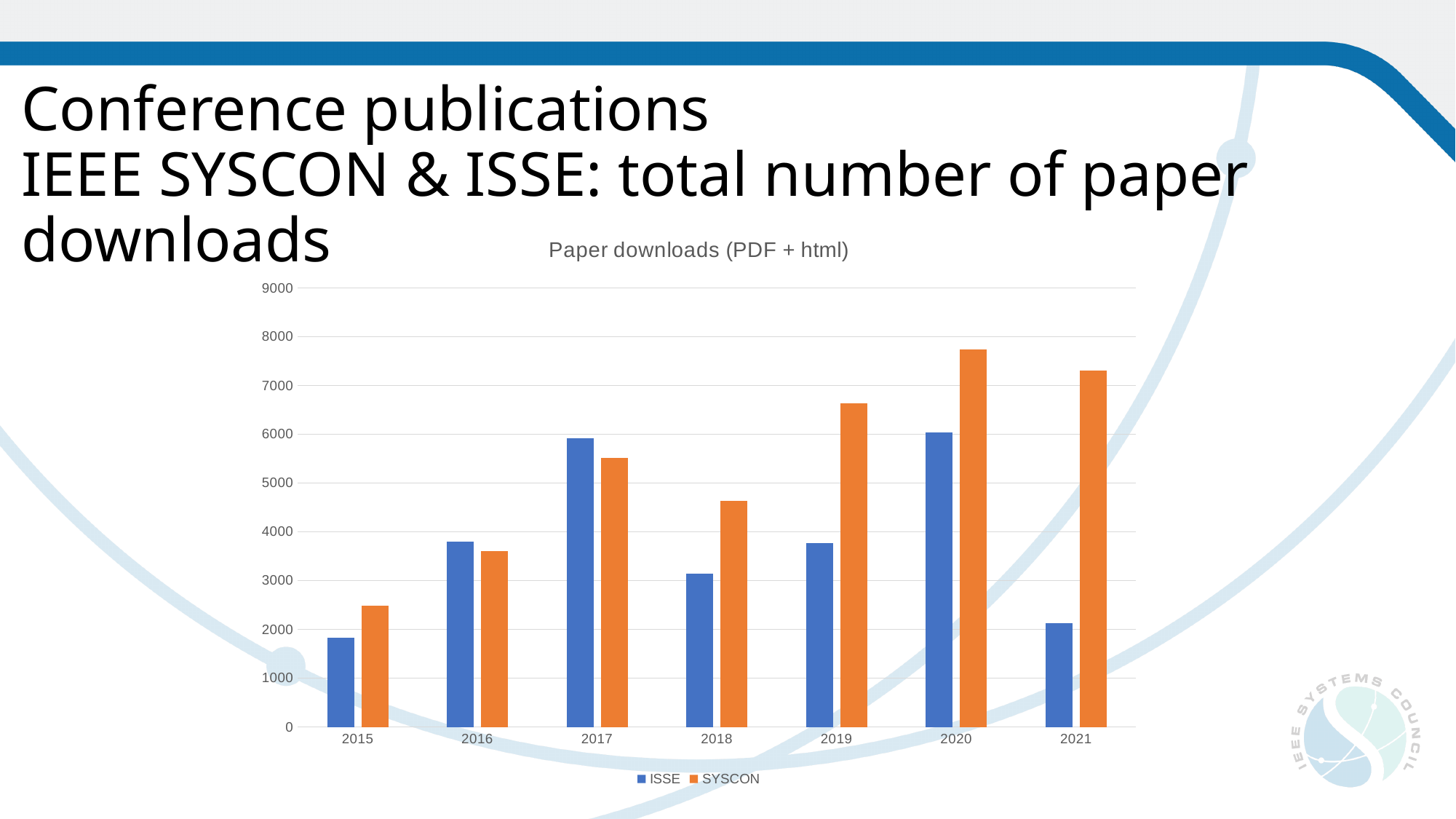
In 2017, which series has the larger value, ISSE or SYSCON? ISSE In 2019, which series has the larger value, ISSE or SYSCON? SYSCON Is the SYSCON value for 2018 greater or less than 4000? greater In which year is the SYSCON value highest? 2020 Is the ISSE value for 2015 greater or less than 2000? less How many years are shown on the x axis? 7 How many series does the legend list? 2 In which year is the SYSCON value lowest? 2015 What kind of chart is shown on the slide? bar chart Is the SYSCON value for 2020 greater or less than 7000? greater In which year is the ISSE value lowest? 2015 What is the title of the chart? Paper downloads (PDF + html)